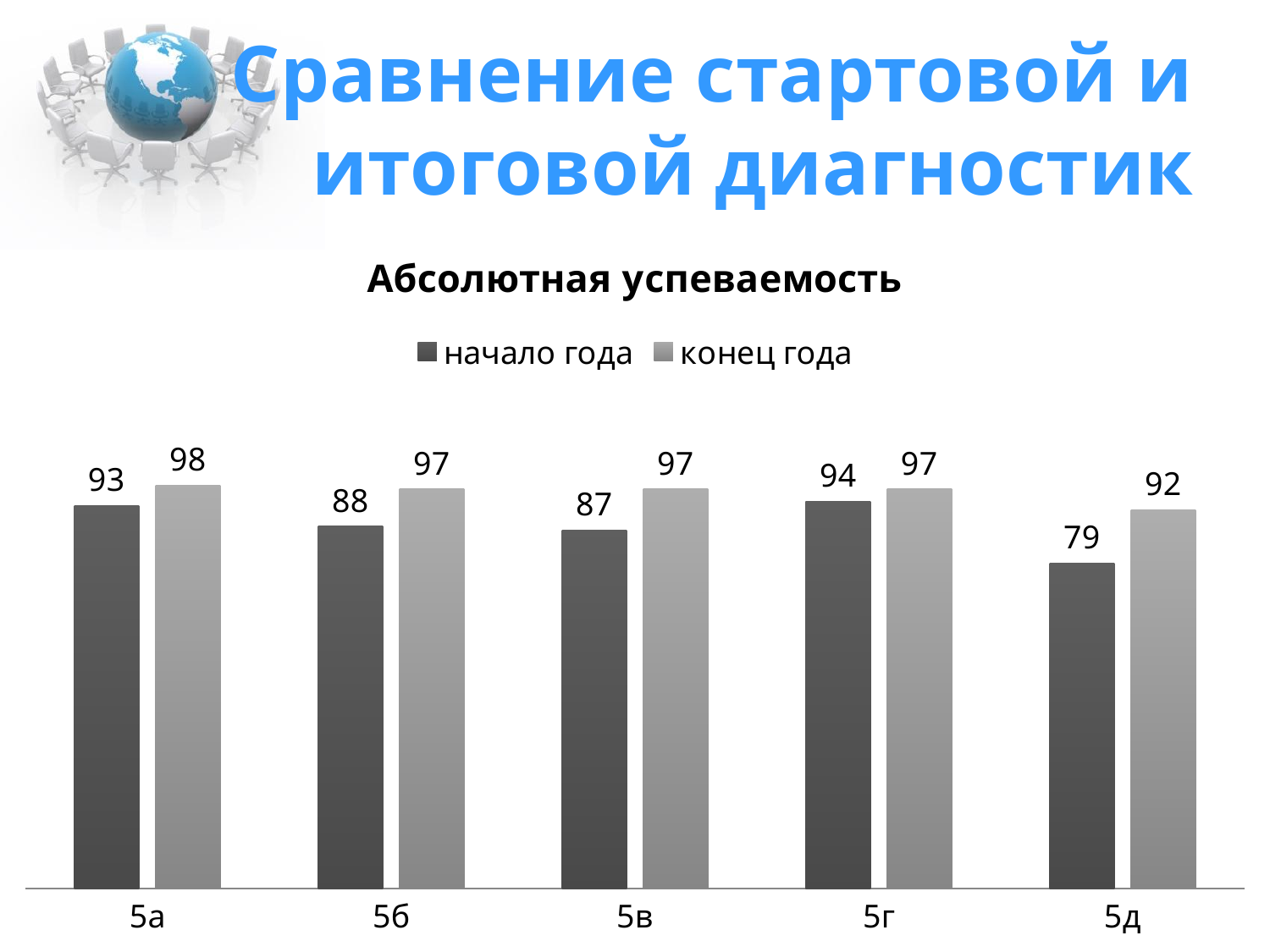
What is the value for 5а in the начало года series? 93 What is the difference between the конец года and начало года values for 5б? 9 What is the value for 5д in the конец года series? 92 Which is larger: the начало года value for 5г or the начало года value for 5в? 5г How many series does the legend list? 2 What is the title of the chart? Абсолютная успеваемость What is the value for 5в in the начало года series? 87 What kind of chart is shown on the slide? bar chart Which category has the highest value in the конец года series? 5а How many categories are shown on the x axis? 5 What is the difference between the конец года and начало года values for 5д? 13 Which category has the lowest value in the начало года series? 5д